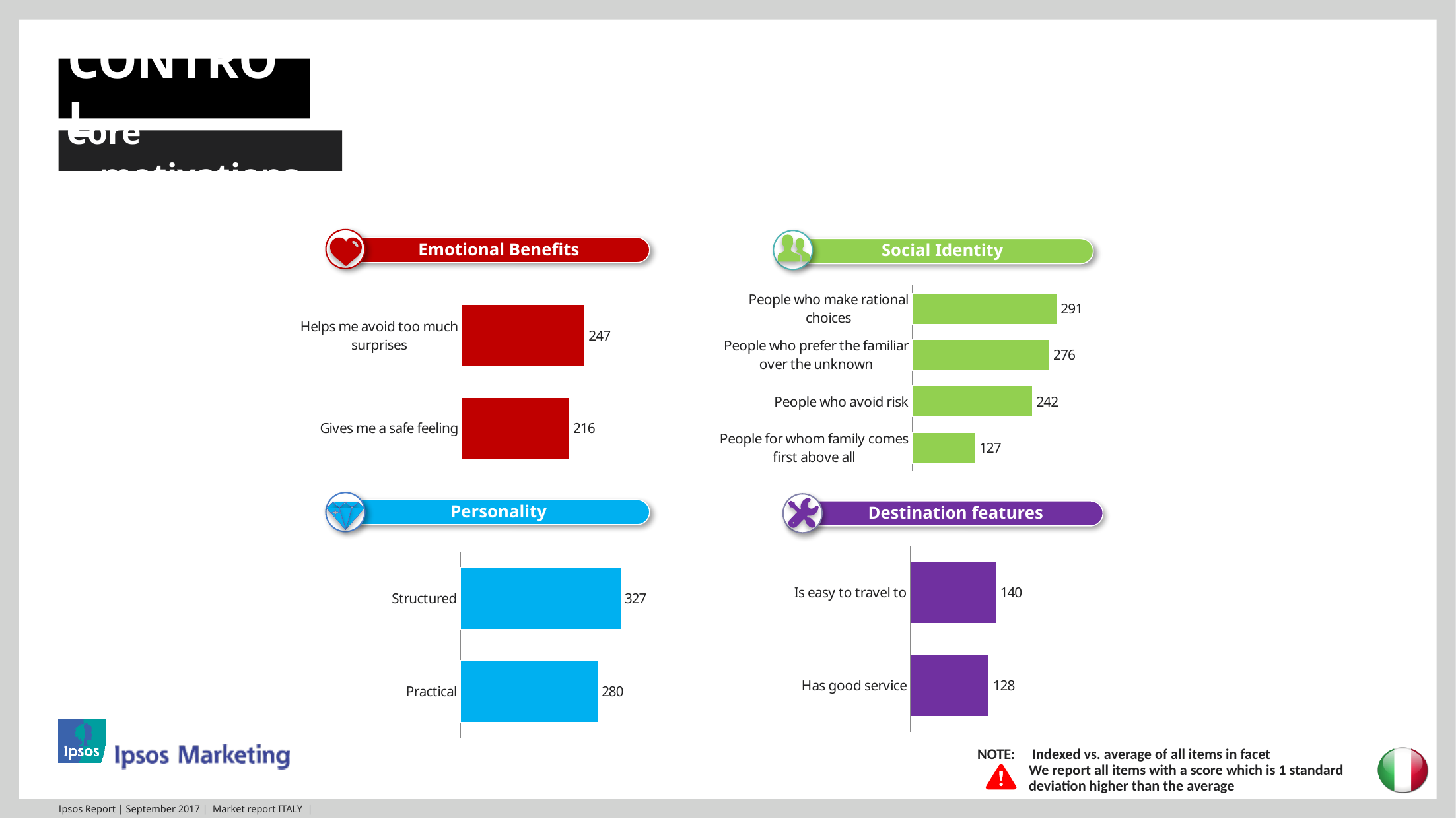
In the Emotional Benefits chart, what is the value for "Helps me avoid too much surprises"? 247 In the Social Identity chart, which category has the lowest value? People for whom family comes first above all How many categories are shown in the Social Identity chart? 4 In the Destination features chart, what is the value for "Has good service"? 128 In the Personality chart, what is the value for "Structured"? 327 In the Social Identity chart, what is the value for "People who avoid risk"? 242 In the Destination features chart, which is larger: "Is easy to travel to" or "Has good service"? Is easy to travel to In the Social Identity chart, what is the difference between "People who make rational choices" and "People who prefer the familiar over the unknown"? 15 What type of chart is the Personality chart? Bar chart In the Personality chart, what is the difference between "Structured" and "Practical"? 47 In the Emotional Benefits chart, what is the value for "Gives me a safe feeling"? 216 In the Social Identity chart, which category has the highest value? People who make rational choices